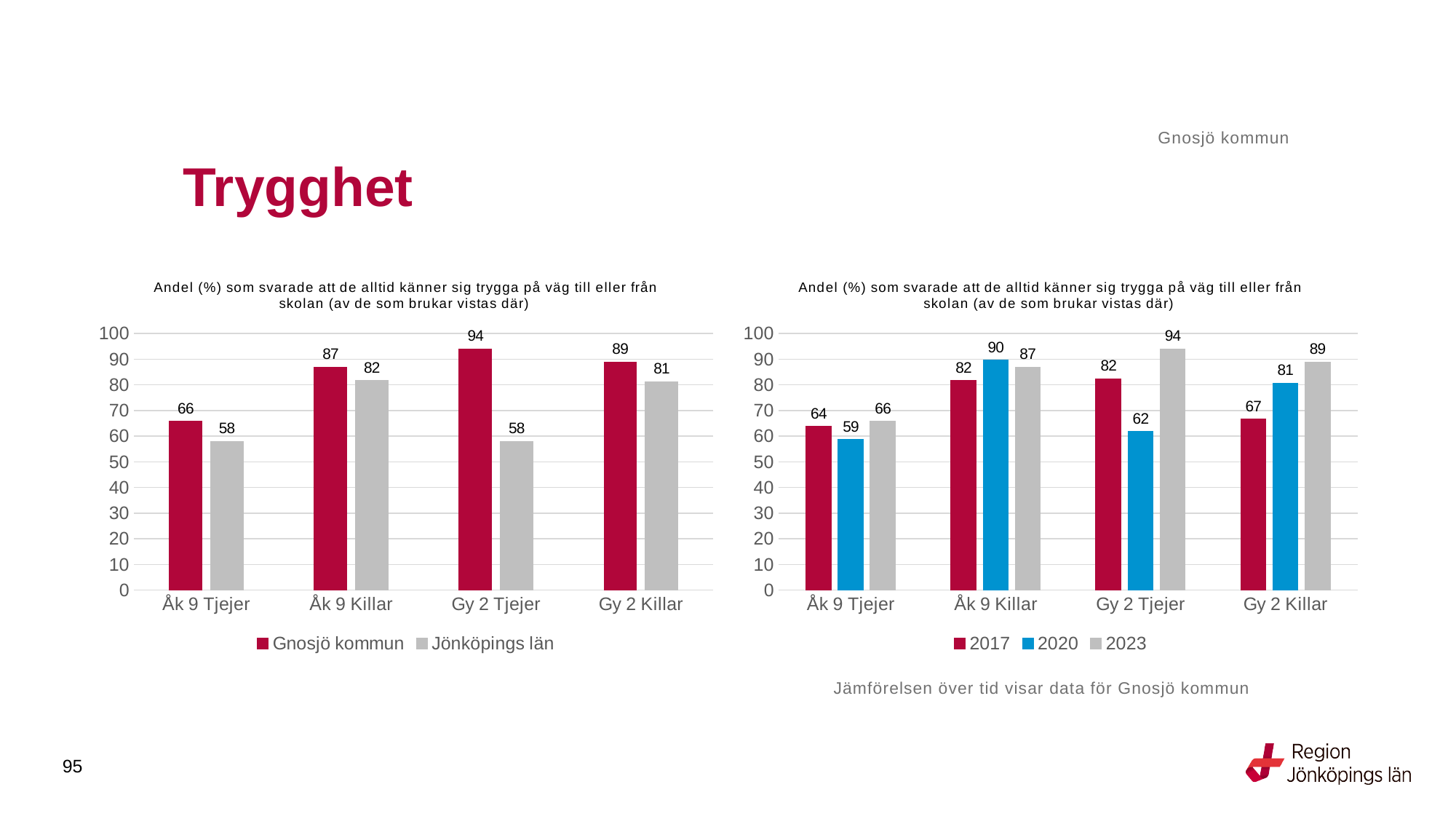
In the left chart, what is the difference between Gnosjö kommun and Jönköpings län for Gy 2 Tjejer? 36 In the left chart, how many series does the legend list? 2 In the right chart, what is the value for 2020 for Åk 9 Killar? 90 In the left chart, what is the value for Gnosjö kommun for Gy 2 Tjejer? 94 In the right chart, which category has the highest value for 2023? Gy 2 Tjejer In the left chart, what is the value for Jönköpings län for Åk 9 Killar? 82 In the left chart, which category has the lowest value for Gnosjö kommun? Åk 9 Tjejer What kind of chart is the right chart? bar chart In the right chart, what is the difference between the 2023 and 2020 values for Gy 2 Tjejer? 32 In the right chart, what is the value for 2017 for Gy 2 Killar? 67 In the right chart, how many categories are shown on the x axis? 4 In the right chart, is the value for 2020 for Gy 2 Tjejer larger or smaller than the value for 2017 for Gy 2 Tjejer? smaller